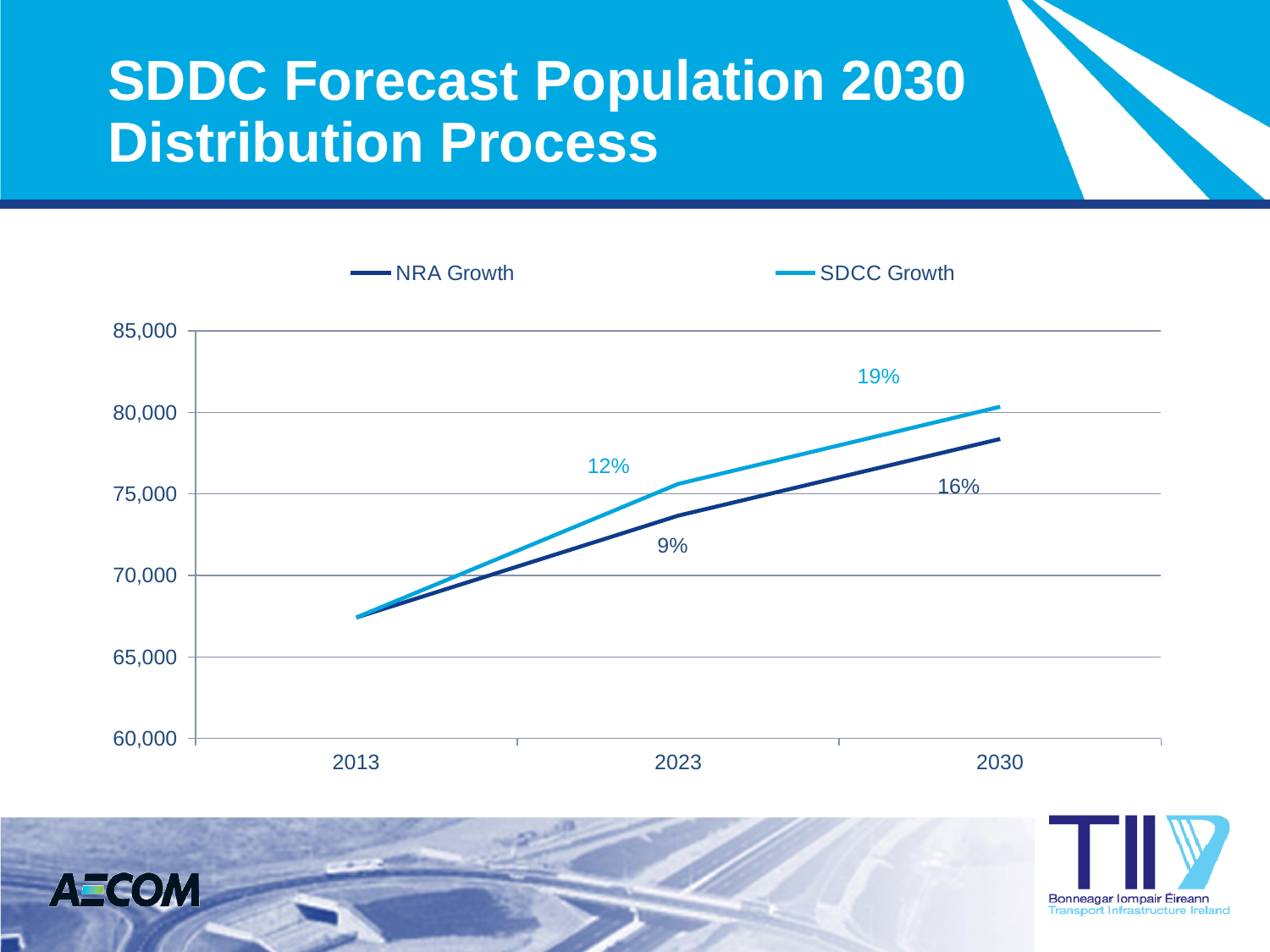
What data label is shown for NRA Growth at 2023? 9% Do the values for SDCC Growth rise or fall from 2013 to 2030? rise Which series is drawn in the lighter blue line? SDCC Growth How many years are marked on the x axis? 3 What data label is shown for NRA Growth at 2030? 16% Is the value for NRA Growth in 2023 greater or less than 75,000? less What data label is shown for SDCC Growth at 2023? 12% How many series does the legend list? 2 What data label is shown for SDCC Growth at 2030? 19% Is the value for NRA Growth in 2030 greater or less than 80,000? less What kind of chart is shown on the slide? line chart Which series is higher in 2030, NRA Growth or SDCC Growth? SDCC Growth